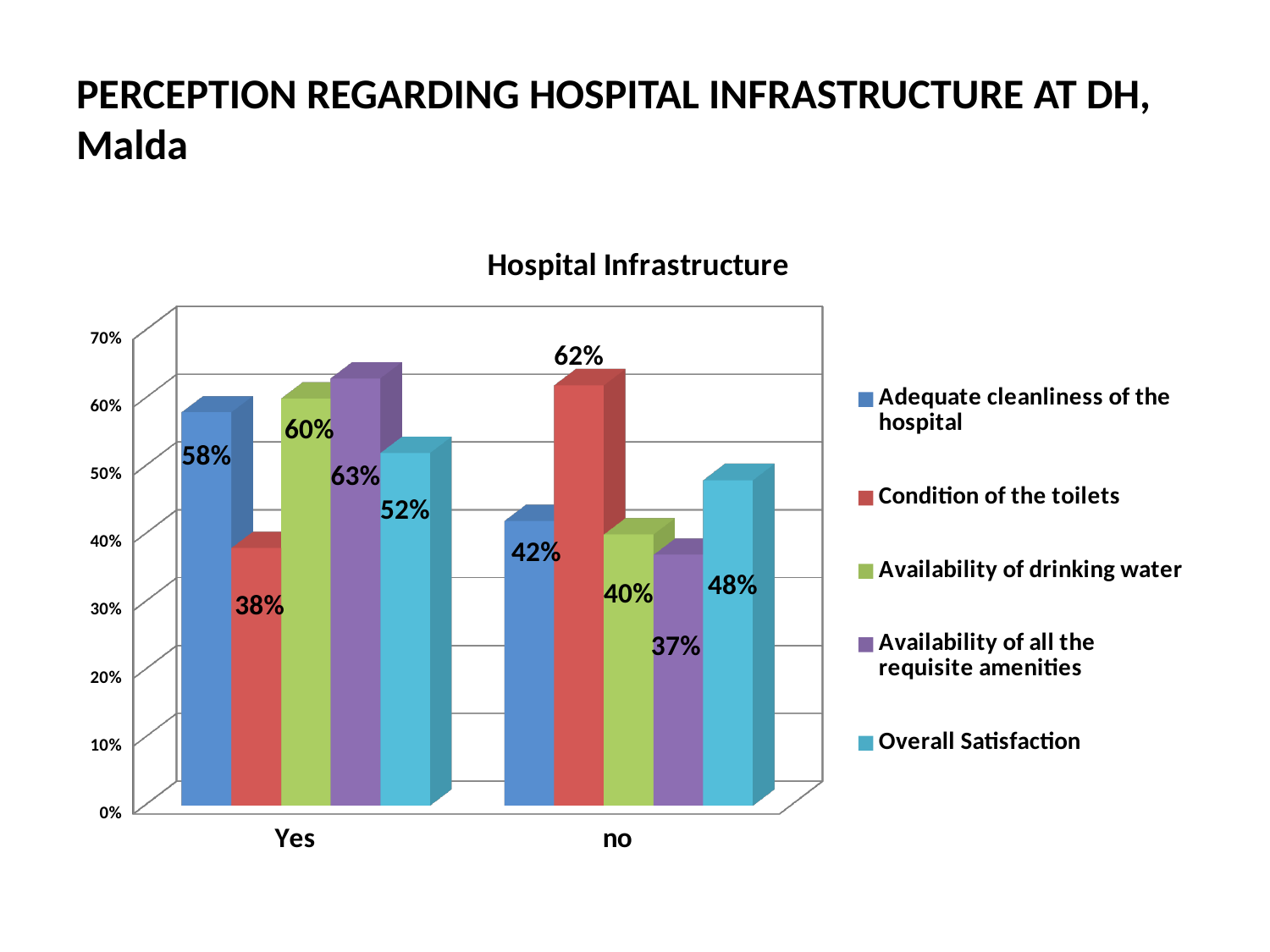
What is the title of the chart? Hospital Infrastructure What is the value for Adequate cleanliness of the hospital in the Yes category? 58% How many series does the legend list? 5 How many categories are shown on the x axis? 2 Which is larger: Availability of drinking water for Yes or for no? Yes What is the value for Availability of all the requisite amenities in the Yes category? 63% Which series has the highest value in the Yes category? Availability of all the requisite amenities What is the value for Condition of the toilets in the no category? 62% Which series has the lowest value in the no category? Availability of all the requisite amenities What kind of chart is shown on the slide? Bar chart What is the value for Overall Satisfaction in the no category? 48% What is the difference between the Yes and no values for Condition of the toilets? 24%